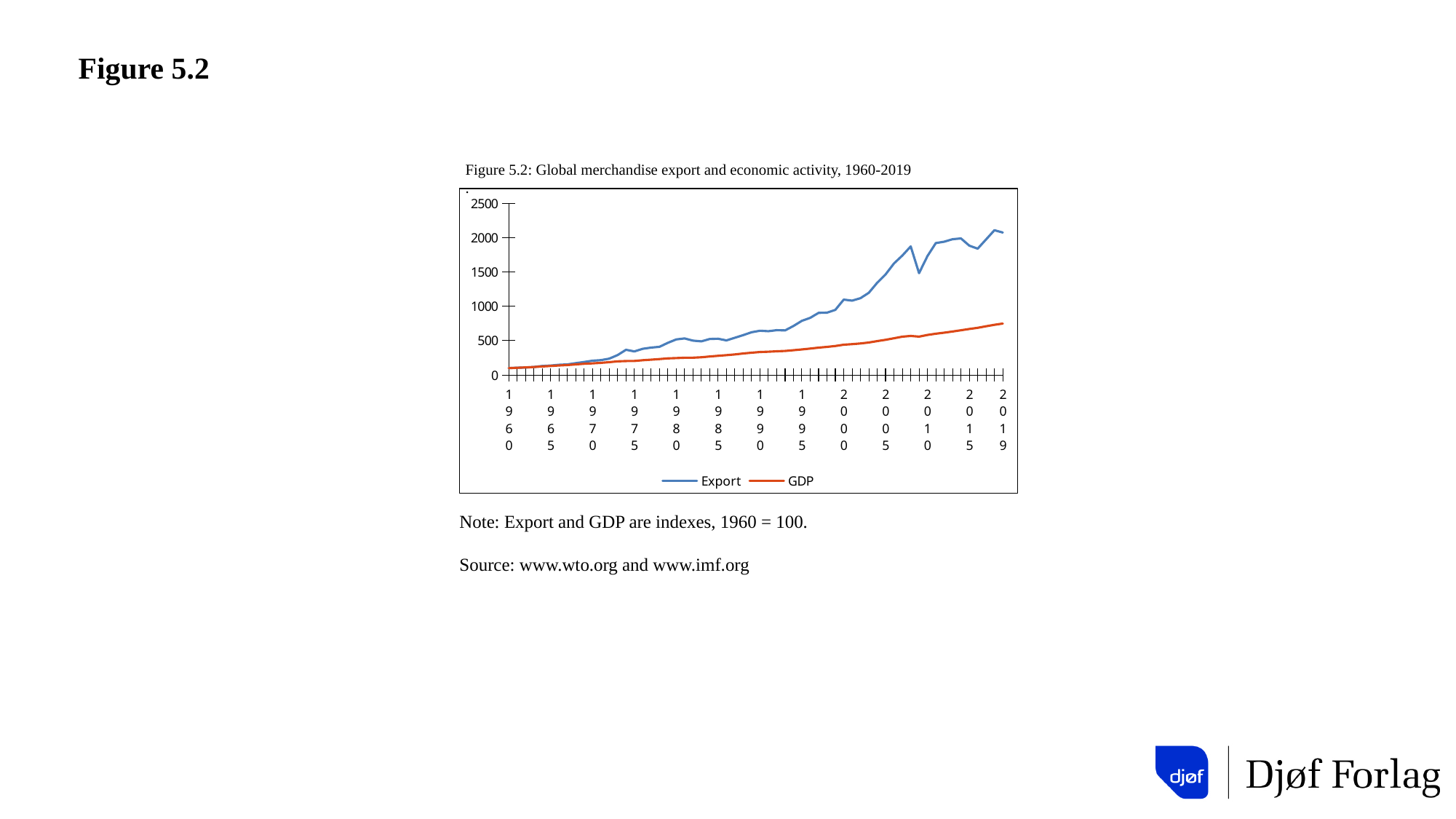
What kind of chart is shown on the slide? line chart Is the value for Export in 2005 greater or less than 1000? greater Is the value for GDP in 2019 greater or less than 1000? less How many year labels are shown on the x axis? 13 Is the value for Export in 2019 greater or less than 1500? greater Which two series are listed in the legend? Export and GDP Does the GDP series generally rise or fall from 1960 to 2019? rise Does the Export series generally rise or fall from 1960 to 2019? rise What is the title of the chart? Figure 5.2: Global merchandise export and economic activity, 1960-2019 Which series has the higher value in 2019, Export or GDP? Export How many series does the legend list? 2